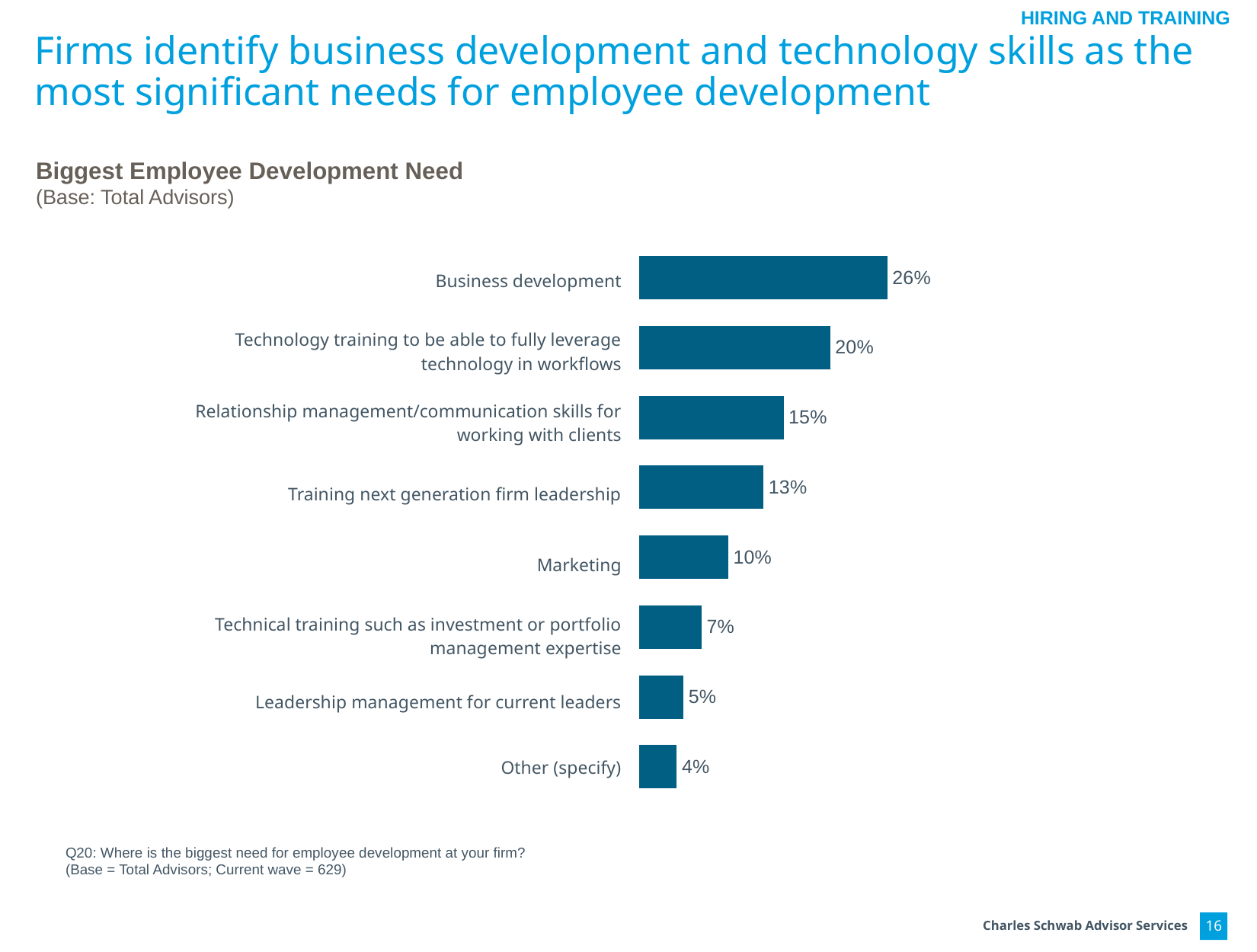
What is the difference between the values for Business development and Technology training to be able to fully leverage technology in workflows? 6% What is the difference between the values for Relationship management/communication skills for working with clients and Marketing? 5% What is the title of the chart? Biggest Employee Development Need What percentage of advisors identified Business development as the biggest employee development need? 26% How many categories are shown in the chart? 8 Which category has the lowest value in the chart? Other (specify) What kind of chart is shown on the slide? Bar chart Which category has the highest value in the chart? Business development What is the value shown for Marketing? 10% What is the value for Leadership management for current leaders? 5% What percentage is shown for Training next generation firm leadership? 13% Which has a larger value: Technical training such as investment or portfolio management expertise or Training next generation firm leadership? Training next generation firm leadership